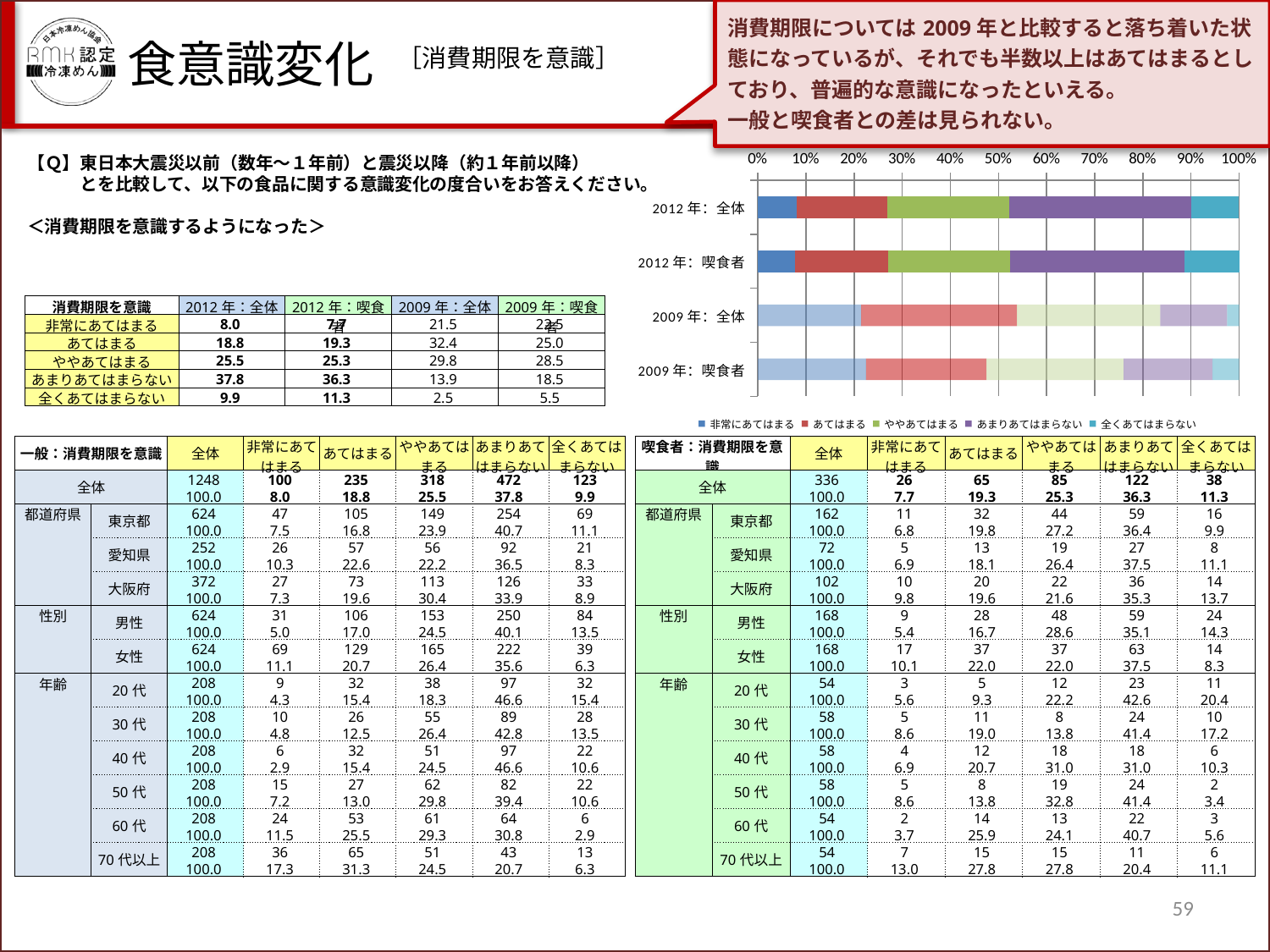
Is the 全くあてはまらない segment for 2009年:全体 greater or less than 10%? less Is the 非常にあてはまる segment for 2012年:全体 greater or less than 10%? less What is the maximum value shown on the chart's horizontal axis? 100% Is the 非常にあてはまる segment for 2009年:全体 greater or less than 10%? greater Which bar has the larger あまりあてはまらない segment, 2012年:全体 or 2009年:全体? 2012年:全体 Which bar has the larger 全くあてはまらない segment, 2012年:喫食者 or 2009年:喫食者? 2012年:喫食者 What is the first entry in the chart's legend? 非常にあてはまる Which bar has the larger あてはまる segment, 2012年:喫食者 or 2009年:喫食者? 2009年:喫食者 How many bars (categories) does the chart on the right show? 4 What kind of chart is shown on the right side of the slide? stacked bar chart How many series does the legend of the chart list? 5